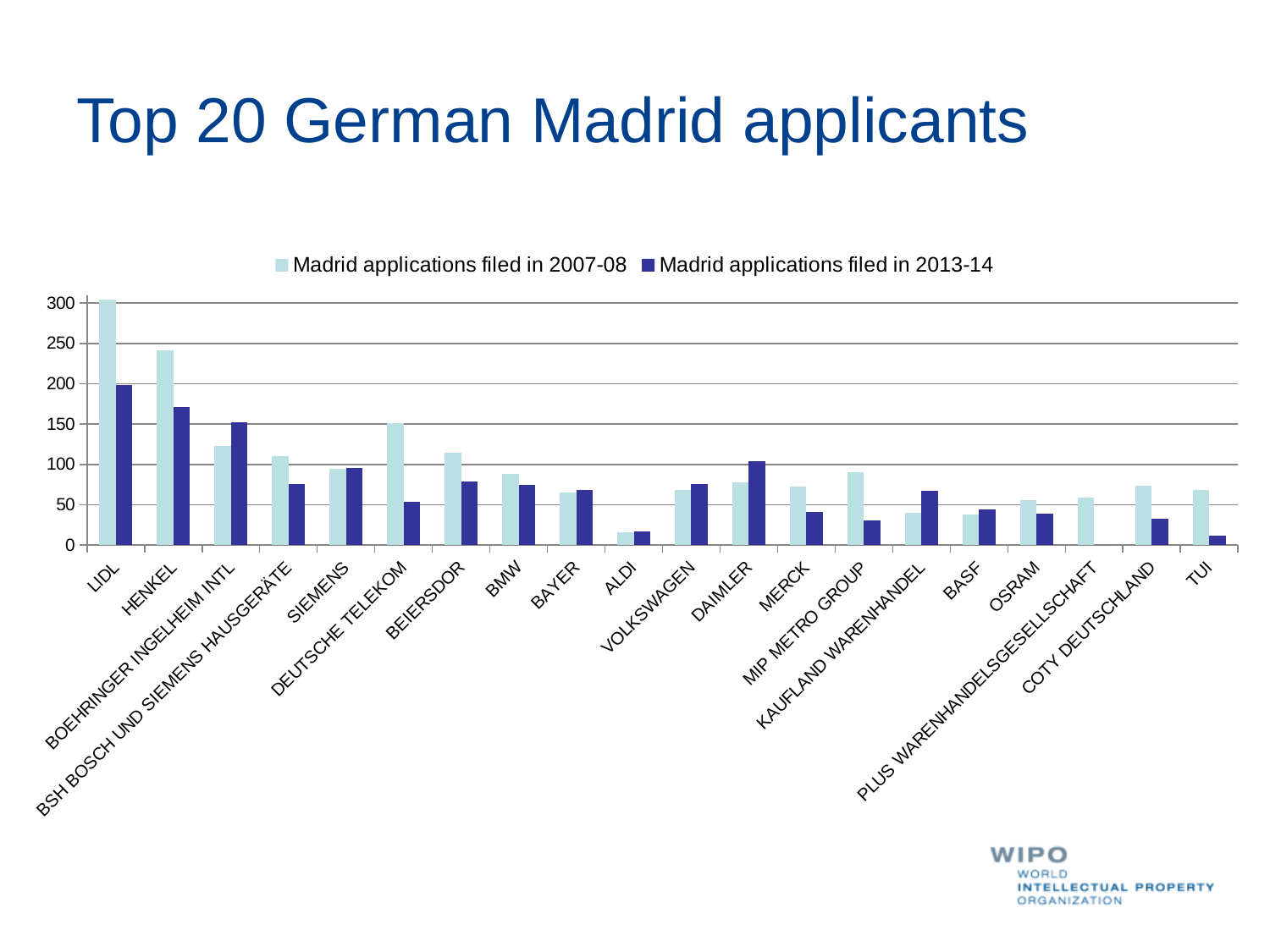
How many series does the legend list? 2 Is the value for LIDL's Madrid applications filed in 2007-08 greater or less than 250? greater Which series is shown in dark blue in the legend? Madrid applications filed in 2013-14 Is the value for DEUTSCHE TELEKOM's Madrid applications filed in 2013-14 greater or less than 100? less Is the value for HENKEL's Madrid applications filed in 2013-14 greater or less than 150? greater Which applicant has the highest number of Madrid applications filed in 2013-14? LIDL How many applicants are shown on the x axis? 20 For DEUTSCHE TELEKOM, which is larger: Madrid applications filed in 2007-08 or in 2013-14? Madrid applications filed in 2007-08 Which applicant has the highest number of Madrid applications filed in 2007-08? LIDL For KAUFLAND WARENHANDEL, which is larger: Madrid applications filed in 2007-08 or in 2013-14? Madrid applications filed in 2013-14 Which applicant has the lowest number of Madrid applications filed in 2007-08? ALDI What kind of chart is shown on the slide? Bar chart